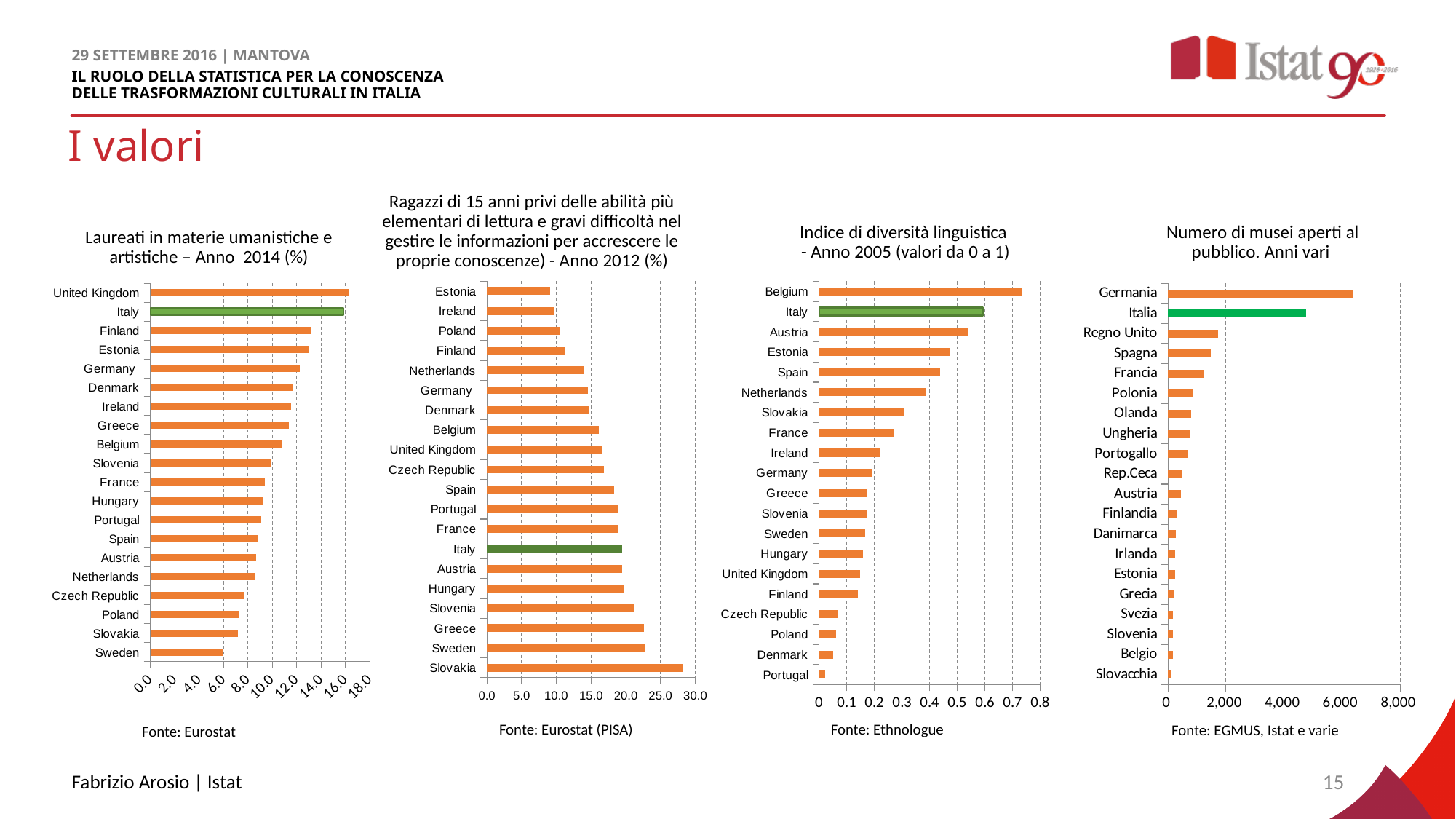
In the chart 'Numero di musei aperti al pubblico. Anni vari', which country has the highest value? Germania In the chart 'Ragazzi di 15 anni privi delle abilità più elementari di lettura... - Anno 2012 (%)', which country has the highest value? Slovakia In the chart 'Numero di musei aperti al pubblico. Anni vari', is the value for Italia greater or less than 4,000? greater In the chart 'Laureati in materie umanistiche e artistiche – Anno 2014 (%)', is the value for Italy greater or less than 14.0? greater In the chart 'Ragazzi di 15 anni privi delle abilità più elementari di lettura... - Anno 2012 (%)', is the value for Italy greater or less than 15.0? greater In the chart 'Laureati in materie umanistiche e artistiche – Anno 2014 (%)', which country has the lowest value? Sweden In the chart 'Laureati in materie umanistiche e artistiche – Anno 2014 (%)', which is larger, the value for Finland or the value for Sweden? Finland In the chart 'Ragazzi di 15 anni privi delle abilità più elementari di lettura... - Anno 2012 (%)', which country has the lowest value? Estonia In the chart 'Laureati in materie umanistiche e artistiche – Anno 2014 (%)', which country has the highest value? United Kingdom How many countries are shown in the chart 'Numero di musei aperti al pubblico. Anni vari'? 20